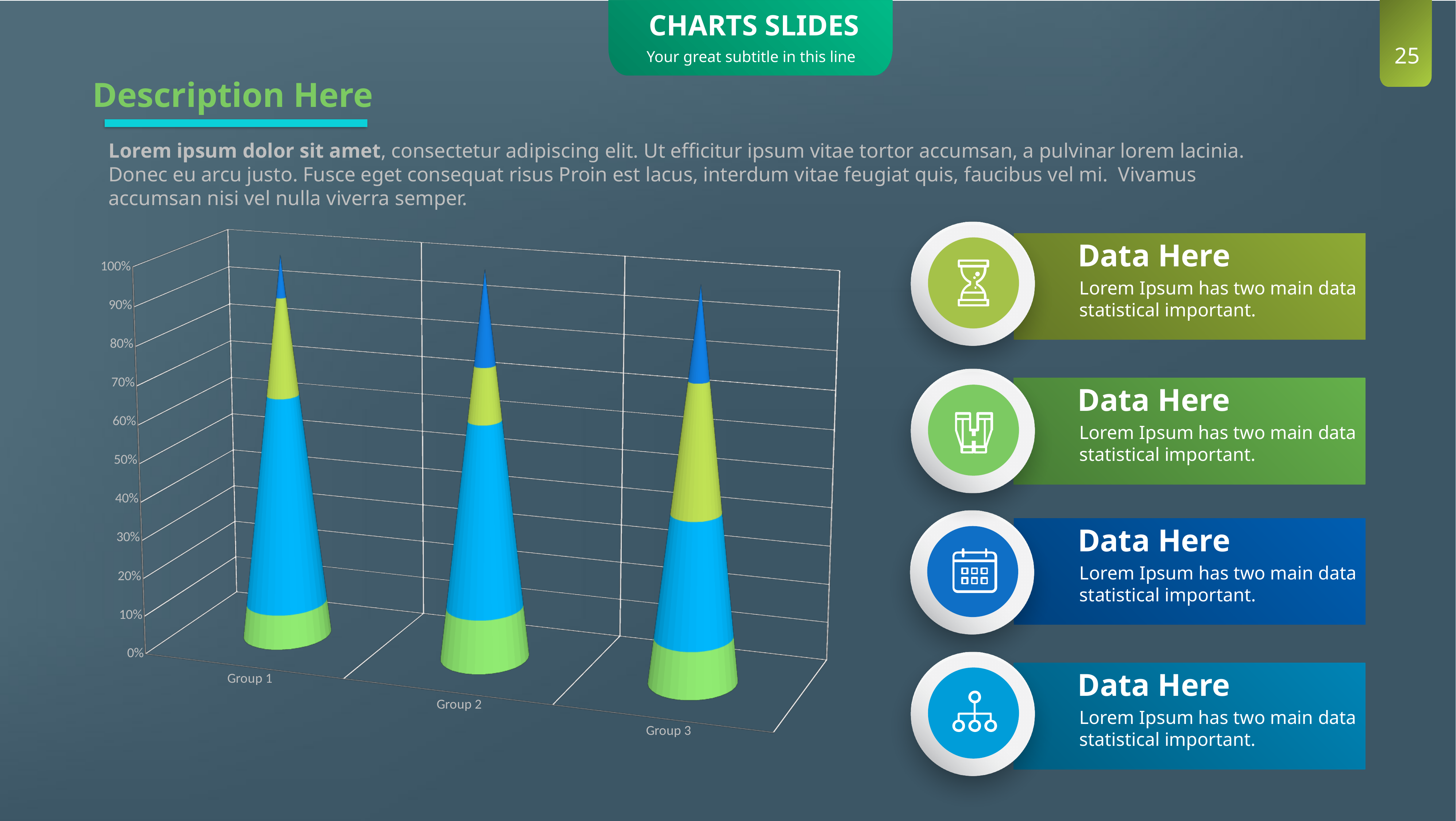
How many groups (categories) are plotted on the x axis of the chart? 3 Which group has the largest yellow-green segment? Group 3 Which group has the smallest light blue segment? Group 3 Is the light blue segment larger for Group 1 or for Group 3? Group 1 Is the green bottom segment for Group 1 greater or less than 30%? less What is the label of the third category on the x axis? Group 3 Is the top of the light blue segment for Group 1 greater or less than 50%? greater Is the yellow-green segment larger for Group 3 or for Group 2? Group 3 What kind of chart is shown on the slide? Stacked bar chart How many colored segments make up each stacked bar in the chart? 4 What is the highest value shown on the vertical axis of the chart? 100% Is the top of the light blue segment for Group 3 greater or less than 50%? less